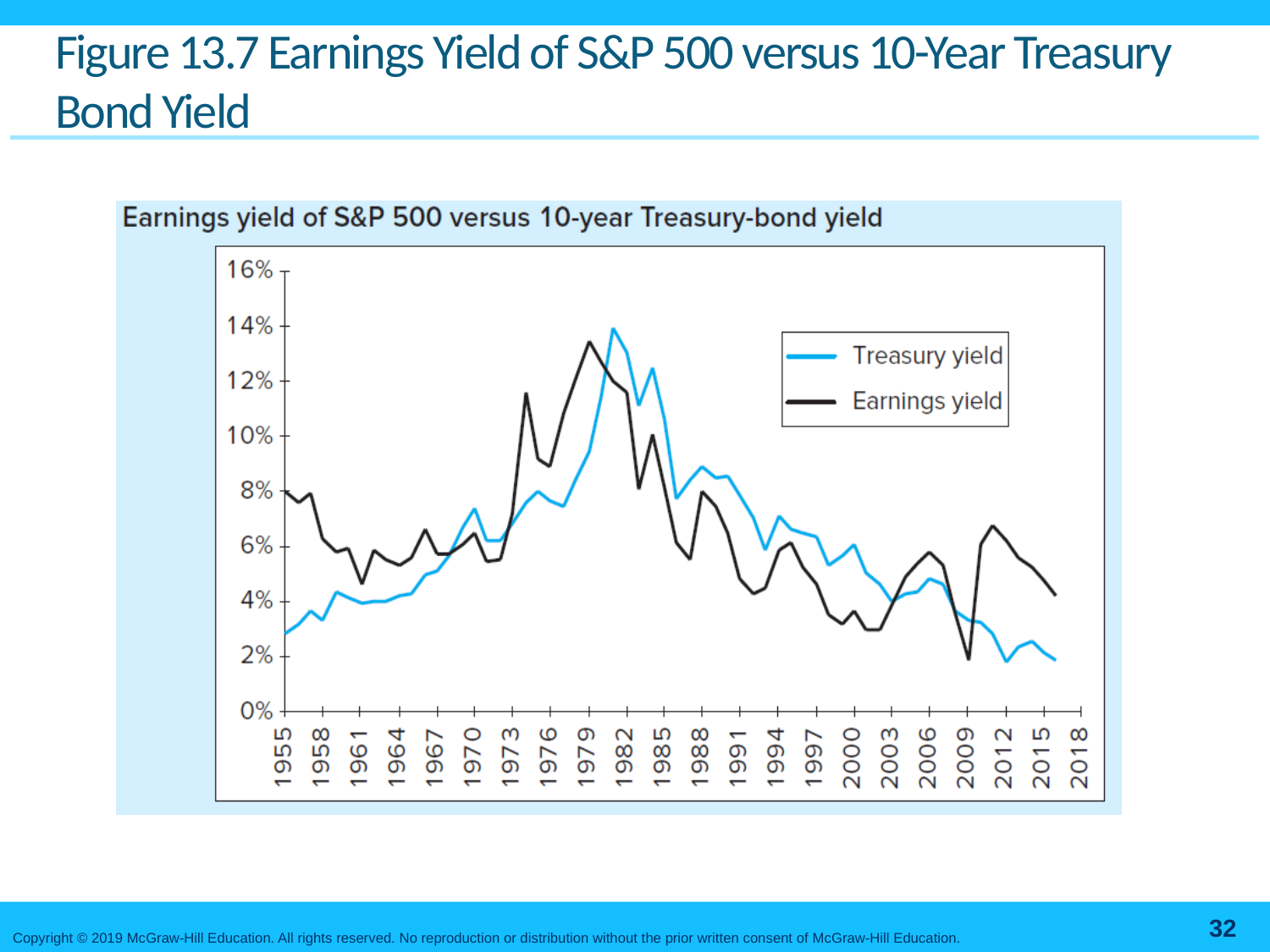
Which colour is used for the Treasury yield line? Blue Is the Treasury yield in 1955 greater or less than 4%? less In 1955, which is higher: the Earnings yield or the Treasury yield? Earnings yield What is the title printed above the chart? Earnings yield of S&P 500 versus 10-year Treasury-bond yield Is the Treasury yield in 2015 greater or less than 4%? less How many series does the legend list? 2 In 2012, which is higher: the Earnings yield or the Treasury yield? Earnings yield What kind of chart is shown on the slide? Line chart Is the Earnings yield in 2009 greater or less than 4%? less How many year labels are shown on the x axis? 22 Does the Treasury yield generally rise or fall from 1982 to 2018? Fall